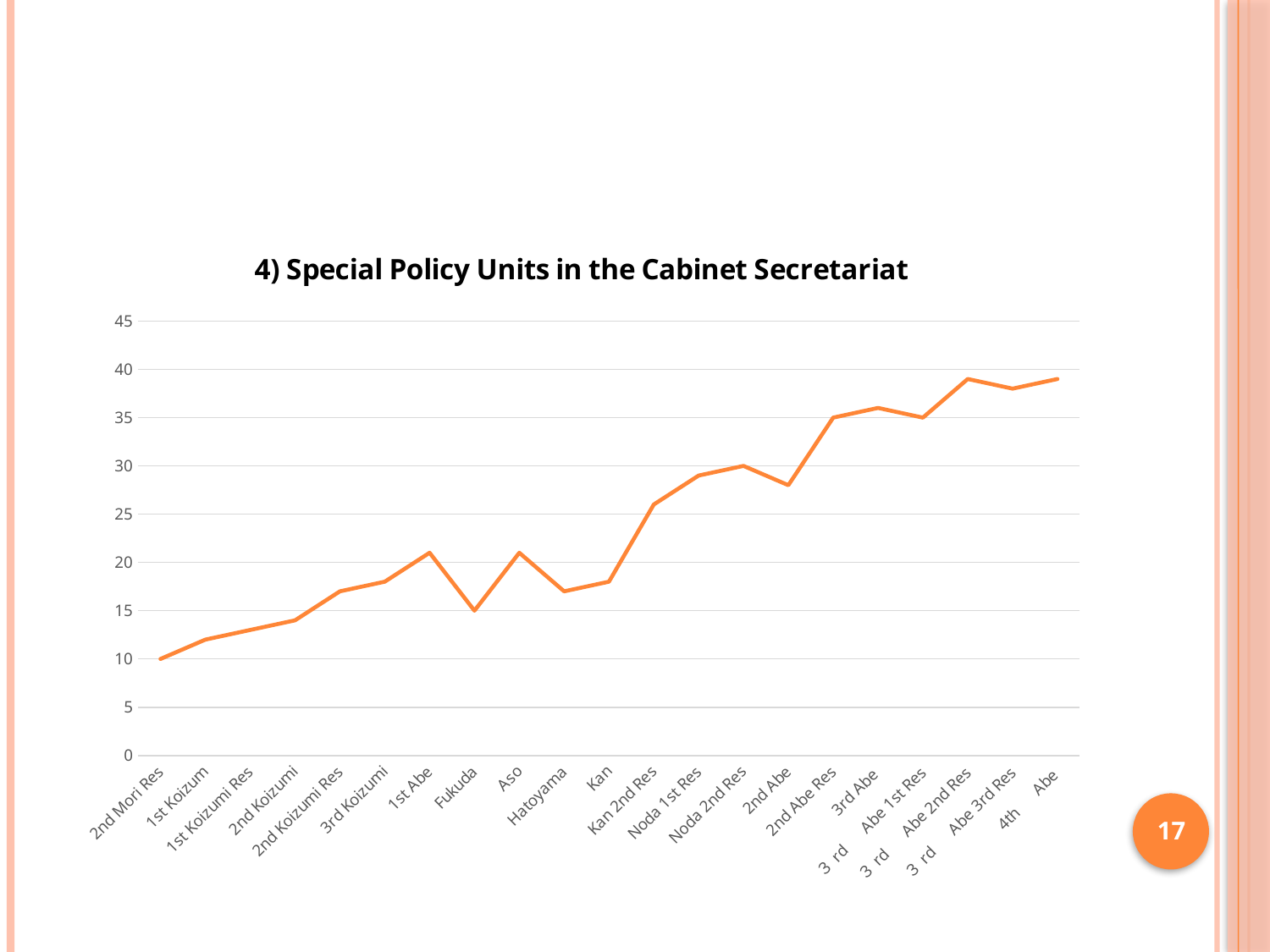
How many cabinets (data points) are plotted along the x axis? 21 What is the value for Noda 2nd Res? 30 Is the value for 2nd Abe greater or less than 30? less Which cabinet has the lowest value? 2nd Mori Res Is the value for Aso greater or less than 20? greater Overall, do the values rise or fall from 2nd Mori Res to 4th Abe? rise What is the value for 2nd Mori Res? 10 What is the value for Fukuda? 15 What kind of chart is shown on the slide? line chart What is the title of the chart? 4) Special Policy Units in the Cabinet Secretariat Which has the larger value, Fukuda or Aso? Aso What is the value for 2nd Abe Res? 35